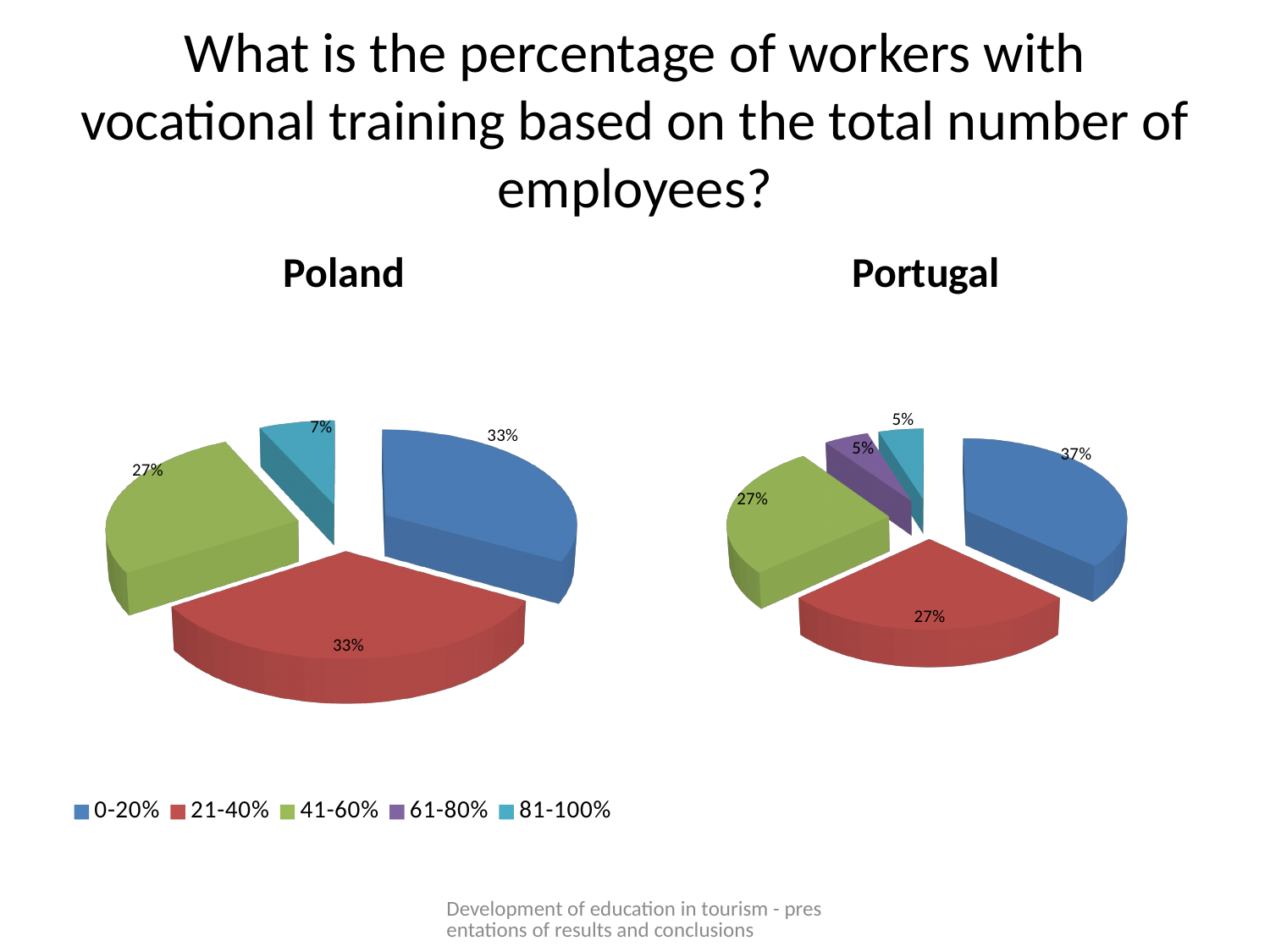
How many slices does the Poland pie chart have? 4 In the Poland pie chart, what share is shown for the 81-100% category? 7% In the Poland pie chart, what is the difference between the 21-40% slice and the 81-100% slice? 26 percentage points In the Poland pie chart, what share is shown for the 41-60% category? 27% In the Portugal pie chart, what share is shown for the 61-80% category? 5% In the Portugal pie chart, what share is shown for the 0-20% category? 37% In the Portugal pie chart, which category has the largest slice? 0-20% How many slices does the Portugal pie chart have? 5 What type of chart is used for Poland and Portugal on this slide? Pie chart How many categories does the shared legend list? 5 Which is larger in the Portugal pie chart: the 0-20% slice or the 21-40% slice? 0-20% In the Poland pie chart, which category has the smallest slice? 81-100%